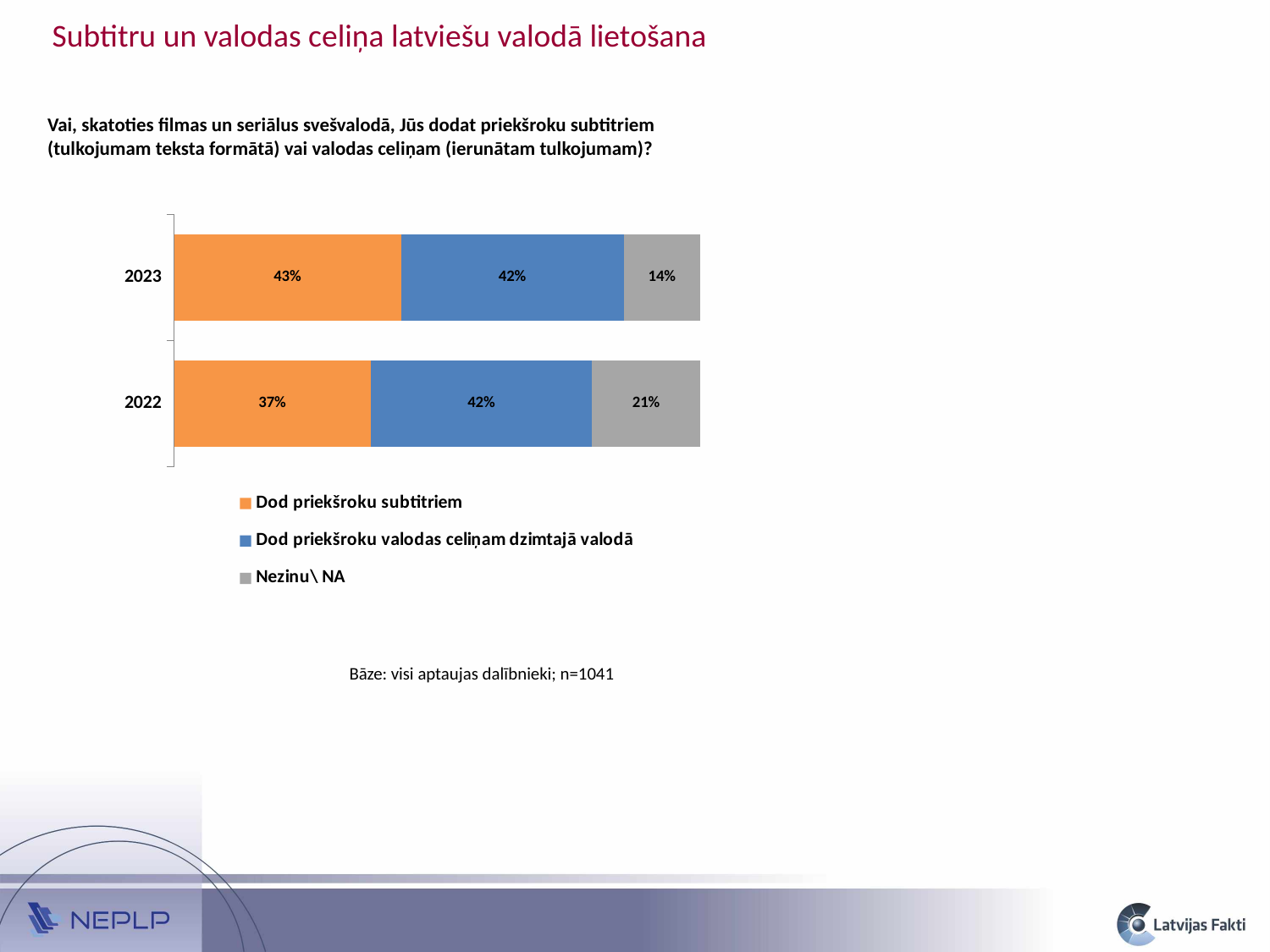
How many series does the legend list? 3 Which year has the larger Nezinu\ NA share, 2022 or 2023? 2022 What percentage of respondents in 2022 preferred the voice track in their native language (Dod priekšroku valodas celiņam dzimtajā valodā)? 42% In 2022, which response category has the largest share? Dod priekšroku valodas celiņam dzimtajā valodā What percentage of respondents in 2023 preferred subtitles (Dod priekšroku subtitriem)? 43% What is the difference between the share preferring subtitles in 2023 and in 2022? 6% How many years (categories) are shown in the chart? 2 What percentage of respondents in 2022 answered Nezinu\ NA? 21% What is the difference between the Nezinu\ NA share in 2022 and in 2023? 7% Which year has the larger share of respondents preferring subtitles, 2022 or 2023? 2023 What kind of chart is shown on the slide? Stacked bar chart In 2023, which response category has the smallest share? Nezinu\ NA